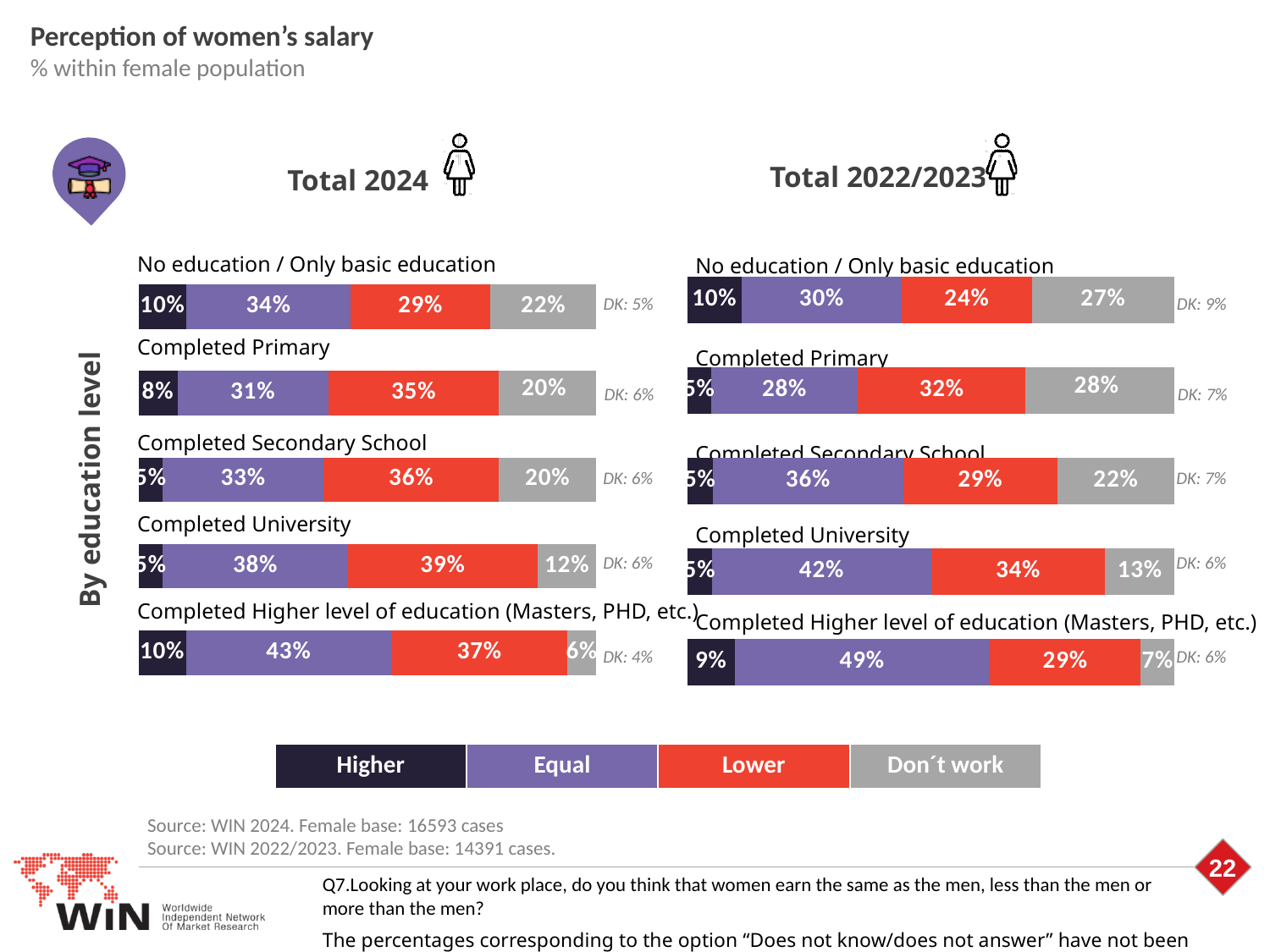
In the Total 2024 chart, how many percentage points higher is the Lower value for Completed Secondary School than for No education / Only basic education? 7 percentage points In the Total 2022/2023 chart, which is larger: the Equal value for Completed University or for Completed Secondary School? Completed University How many series does the legend list? 4 In the Total 2022/2023 chart, what percentage of women with a Completed Higher level of education (Masters, PHD, etc.) said their salary is Equal? 49% In the Total 2024 chart, what percentage of women with a Completed Higher level of education (Masters, PHD, etc.) said their salary is Equal? 43% In the Total 2022/2023 chart, what is the Lower value for Completed Primary? 32% In the Total 2024 chart, which education level has the highest Equal value? Completed Higher level of education (Masters, PHD, etc.) In the Total 2024 chart, which education level has the lowest Don't work value? Completed Higher level of education (Masters, PHD, etc.) In the Total 2024 chart, what is the Lower value for Completed University? 39% In the Total 2022/2023 chart, what is the Don't work value for No education / Only basic education? 27% How many education levels are shown in the Total 2024 chart? 5 What kind of chart is used on this slide? Stacked bar chart